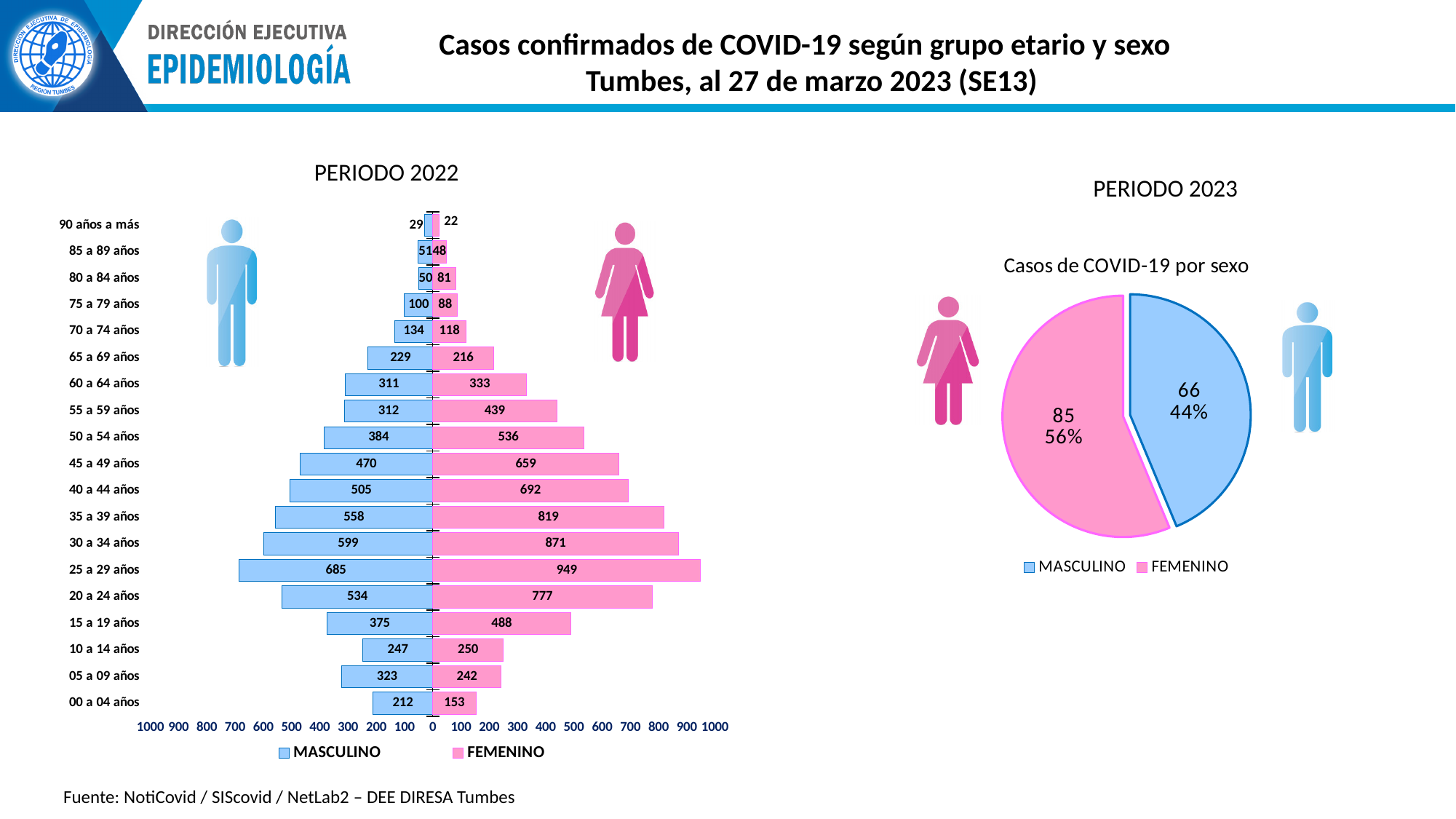
In the PERIODO 2022 chart, how many series does the legend list? 2 In the PERIODO 2022 chart, which age group has the lowest FEMENINO value? 90 años a más In the PERIODO 2023 pie chart, what share of cases is FEMENINO? 56% In the PERIODO 2022 chart, which age group has the highest MASCULINO value? 25 a 29 años What is the title of the PERIODO 2023 pie chart? Casos de COVID-19 por sexo In the PERIODO 2022 chart, what is the MASCULINO value for the 30 a 34 años age group? 599 In the PERIODO 2022 chart, what is the FEMENINO value for the 25 a 29 años age group? 949 In the PERIODO 2022 chart, how many age groups are shown? 19 What kind of chart is the PERIODO 2022 chart? Bar chart In the PERIODO 2022 chart, which is larger for the 05 a 09 años age group, MASCULINO or FEMENINO? MASCULINO In the PERIODO 2023 pie chart, what is the MASCULINO value? 66 In the PERIODO 2022 chart, what is the difference between the FEMENINO and MASCULINO values for the 35 a 39 años age group? 261